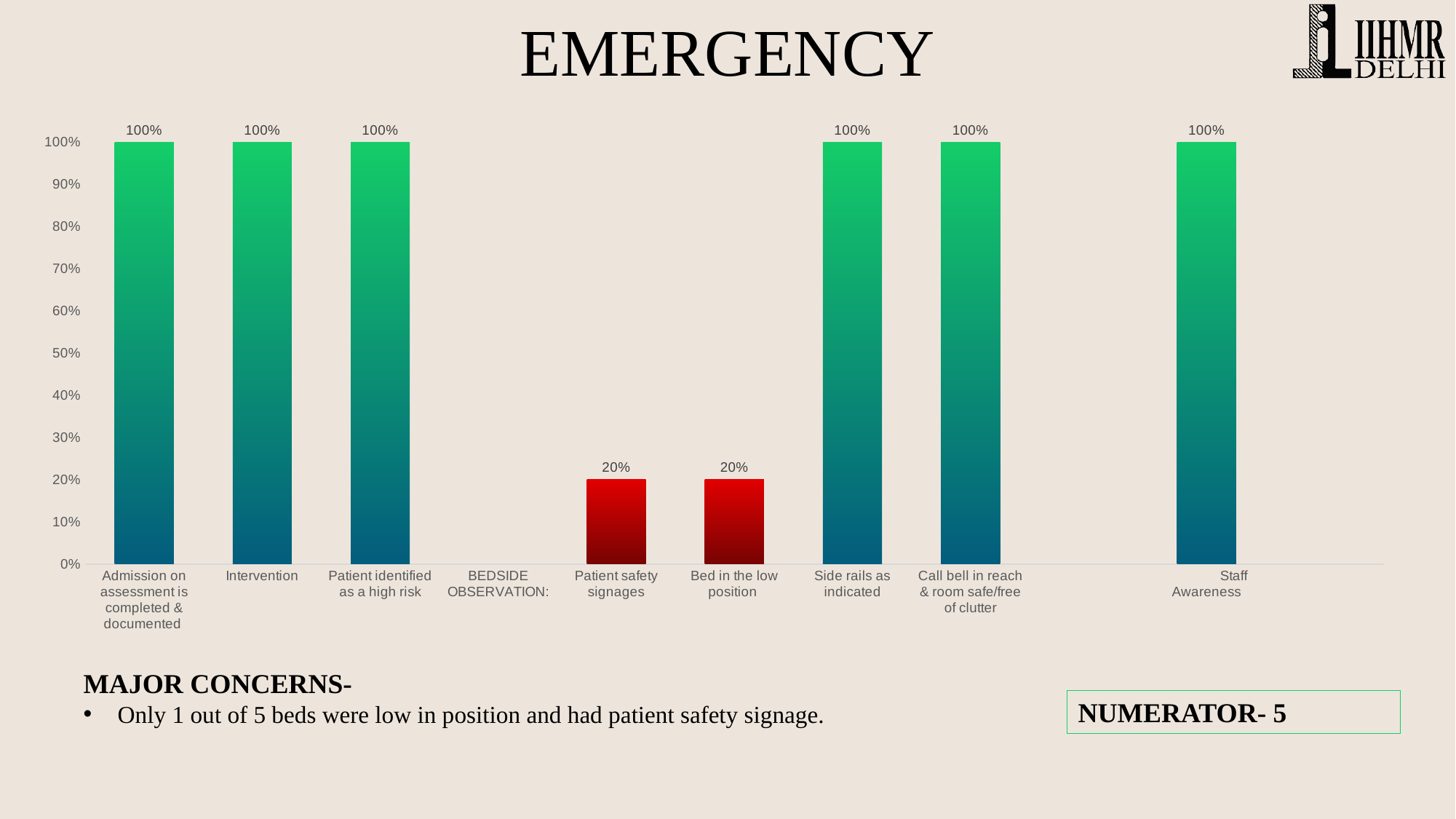
What is the value for Side rails as indicated? 100% What is the value for Patient safety signages? 20% How many bars show a value of 20%? 2 Is the value for Patient safety signages greater or less than 50%? less What is the value for Staff Awareness? 100% What is the value for Intervention? 100% Which category has the lowest value, Patient safety signages or Side rails as indicated? Patient safety signages How many bars are plotted in the chart? 8 What colour are the bars for Patient safety signages and Bed in the low position? red What is the value for Bed in the low position? 20% What is the difference between the value for Call bell in reach & room safe/free of clutter and the value for Bed in the low position? 80% What kind of chart is shown on the slide? bar chart